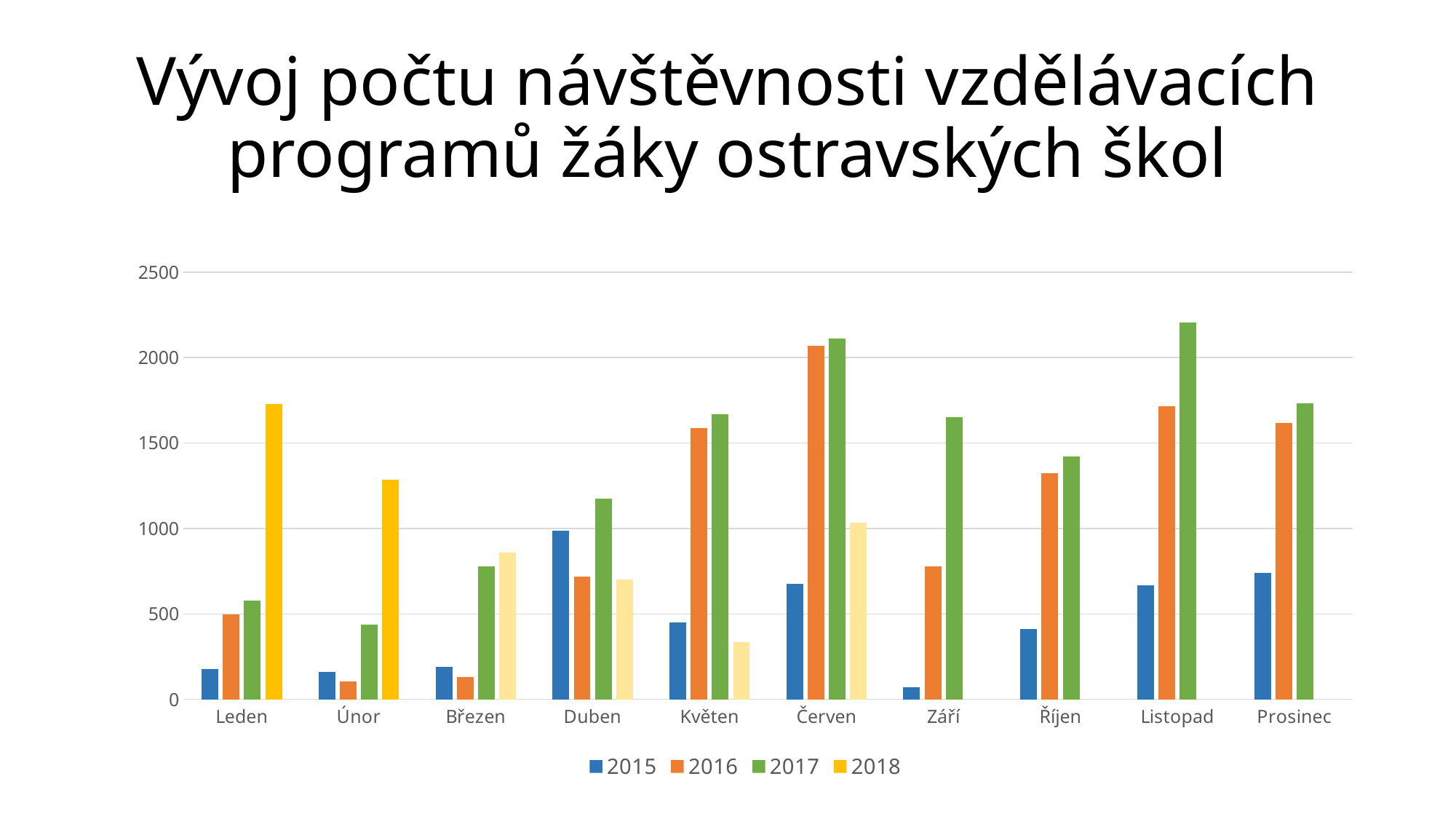
Which month has the lowest bar for 2015? Září What entries does the legend list? 2015, 2016, 2017, 2018 Which month has the highest bar for 2017? Listopad Is the value for 2018 in Leden greater or less than 1500? greater Is the value for 2016 in Červen greater or less than 2000? greater Which is larger: the 2018 value in Leden or the 2018 value in Únor? Leden Which year has the highest bar in Duben? 2017 How many series does the legend list? 4 In Duben, which is larger: the value for 2015 or the value for 2016? 2015 Is the value for 2017 in Září greater or less than 1500? greater What kind of chart is shown on the slide? bar chart How many months are shown on the x axis? 10